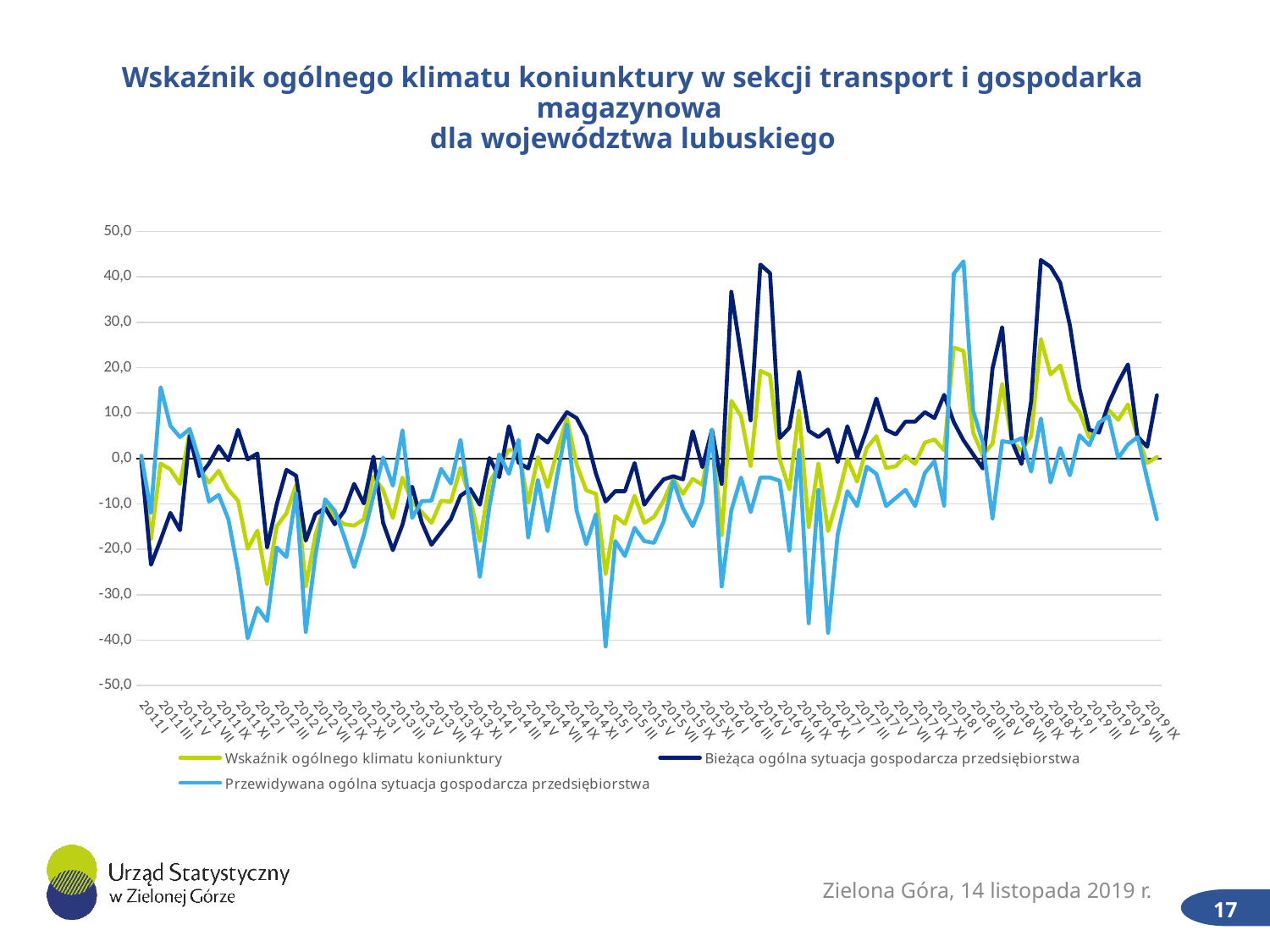
Which series reaches the lowest value anywhere on the chart? Przewidywana ogólna sytuacja gospodarcza przedsiębiorstwa What is the highest value shown on the vertical axis? 50,0 What kind of chart is shown on the slide? line chart Which series is drawn in the yellow-green colour? Wskaźnik ogólnego klimatu koniunktury Around 2016 III, which series has the larger value: 'Bieżąca ogólna sytuacja gospodarcza przedsiębiorstwa' or 'Przewidywana ogólna sytuacja gospodarcza przedsiębiorstwa'? Bieżąca ogólna sytuacja gospodarcza przedsiębiorstwa Is the peak value of the 'Przewidywana ogólna sytuacja gospodarcza przedsiębiorstwa' series around 2018 I greater or less than 40? greater Is the lowest value of the 'Przewidywana ogólna sytuacja gospodarcza przedsiębiorstwa' series, around 2015 I, greater or less than -30? less How many series does the legend list? 3